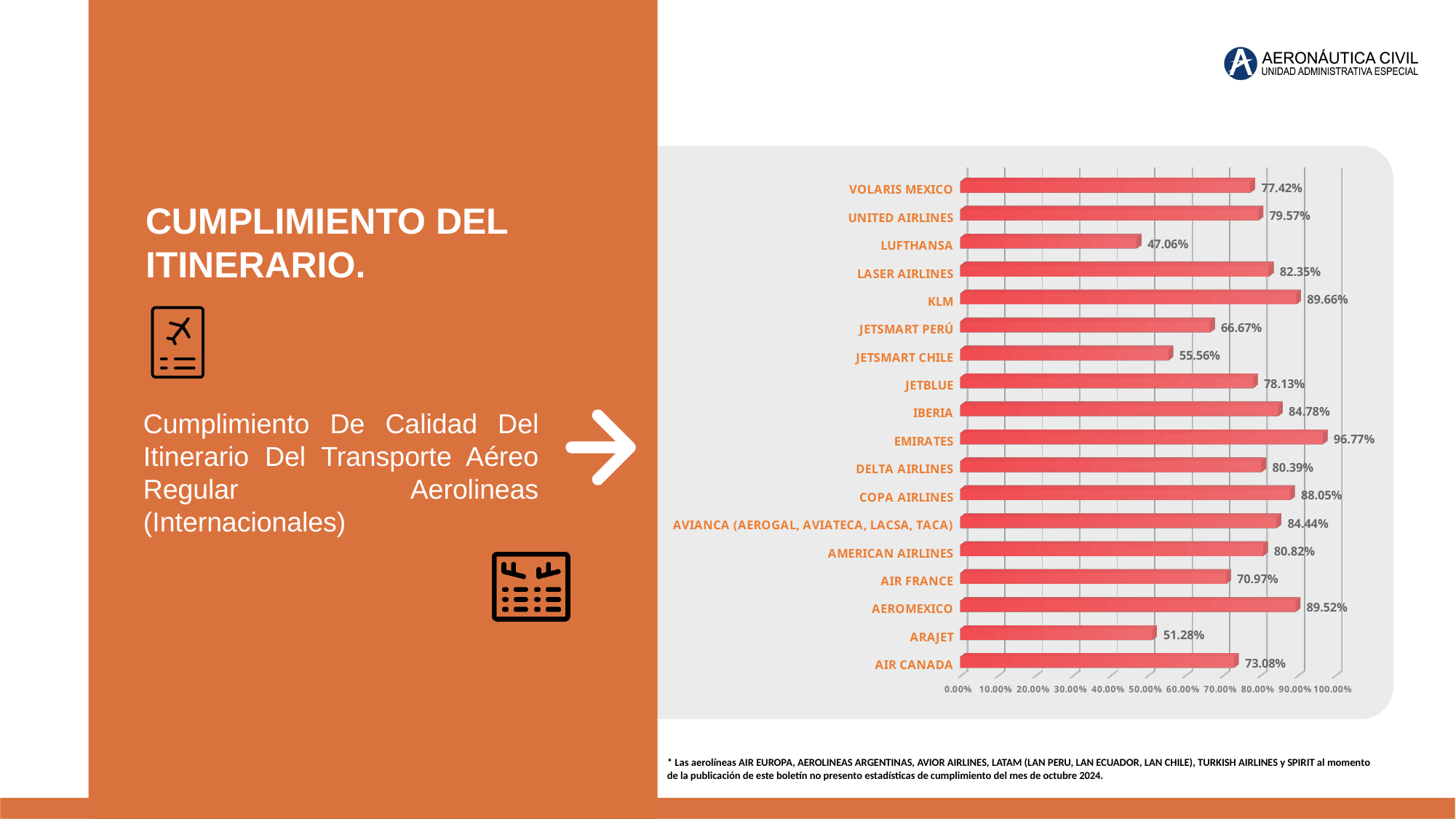
What is the value for AIR CANADA? 73.08% What is the value for LUFTHANSA? 47.06% What kind of chart is shown on the slide? Bar chart What is the difference between the values for COPA AIRLINES and AIR CANADA? 14.97% Which airline has the lowest value? LUFTHANSA How many airlines are shown in the chart? 18 Which airline has the highest value? EMIRATES What is the highest tick value shown on the horizontal axis? 100.00% What is the value for EMIRATES? 96.77% What is the difference between the values for EMIRATES and LUFTHANSA? 49.71% Which is larger, the value for IBERIA or the value for AVIANCA (AEROGAL, AVIATECA, LACSA, TACA)? IBERIA What is the value for JETSMART CHILE? 55.56%